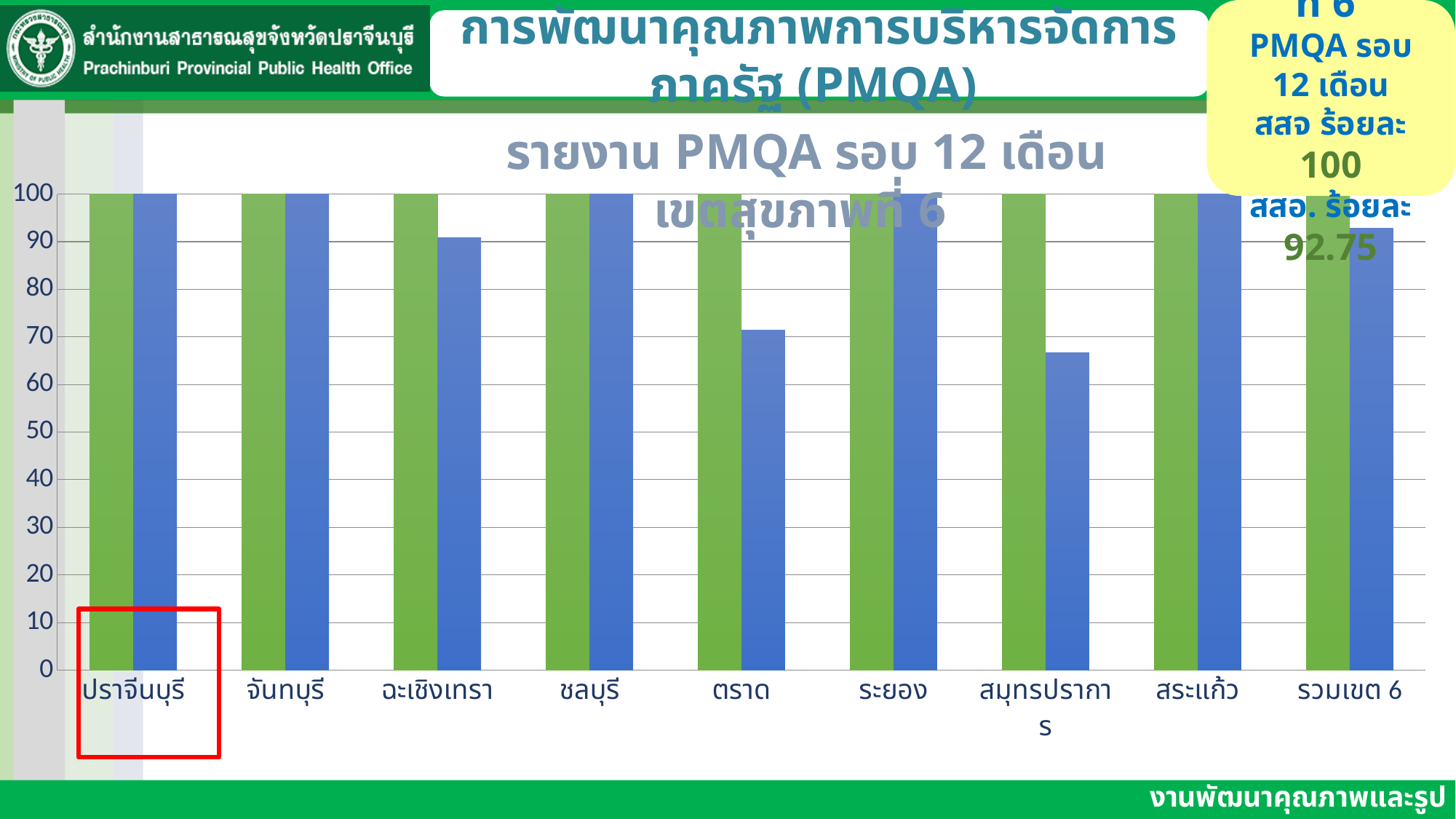
Is the value of the blue bar for ฉะเชิงเทรา greater or less than 80? greater What is the value of the blue bar for ระยอง? 100 What colours are the two series of bars in the chart? green and blue Which is larger, the blue bar for ตราด or the blue bar for สมุทรปราการ? ตราด For ตราด, which is larger, the green bar or the blue bar? green bar What kind of chart is shown on the slide? bar chart Is the value of the blue bar for สมุทรปราการ greater or less than 60? greater How many categories are shown along the x axis of the chart? 9 What is the title of the chart? รายงาน PMQA รอบ 12 เดือน เขตสุขภาพที่ 6 Is the value of the blue bar for ตราด greater or less than 80? less What is the value of the green bar for ชลบุรี? 100 Which category has the lowest blue bar? สมุทรปราการ